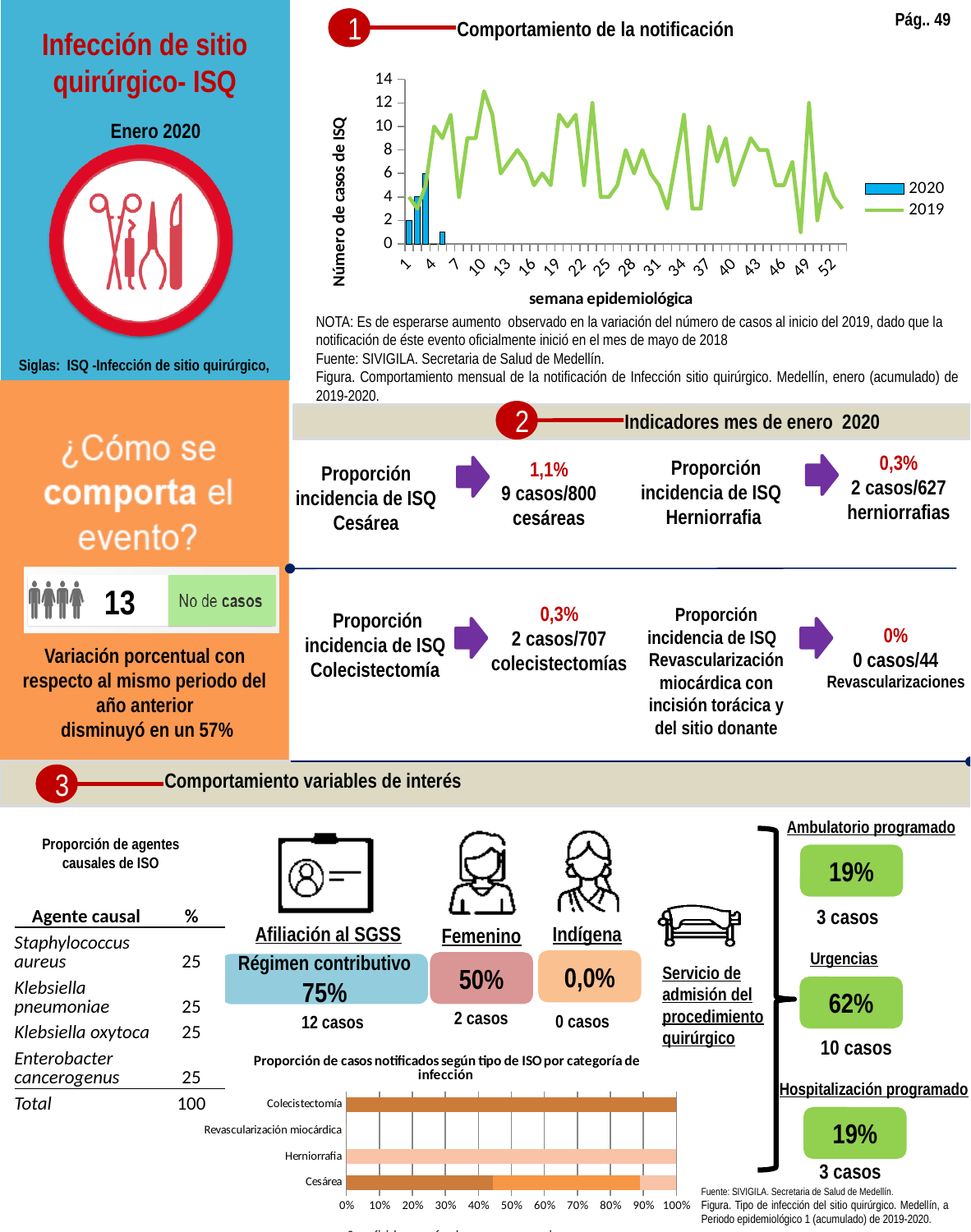
What kind of chart is 'Proporción de casos notificados según tipo de ISO por categoría de infección'? bar chart In the chart 'Comportamiento de la notificación', is the 2019 value for week 1 greater or less than 2? greater In the chart 'Comportamiento de la notificación', which 2020 bar is taller: week 3 or week 5? week 3 In the chart 'Comportamiento de la notificación', is the 2019 value for week 10 greater or less than 12? greater In the chart 'Comportamiento de la notificación', is the 2020 value for week 3 greater or less than 4? greater In the chart 'Proporción de casos notificados según tipo de ISO por categoría de infección', which category has no bar plotted? Revascularización miocárdica In the chart 'Comportamiento de la notificación', what are the two series named in the legend? 2020 and 2019 How many categories are listed on the vertical axis of the chart 'Proporción de casos notificados según tipo de ISO por categoría de infección'? 4 In the chart 'Comportamiento de la notificación', which series is drawn as bars rather than a line? 2020 In the chart 'Comportamiento de la notificación', how many series does the legend list? 2 In the chart 'Comportamiento de la notificación', what is the title of the vertical axis? Número de casos de ISQ